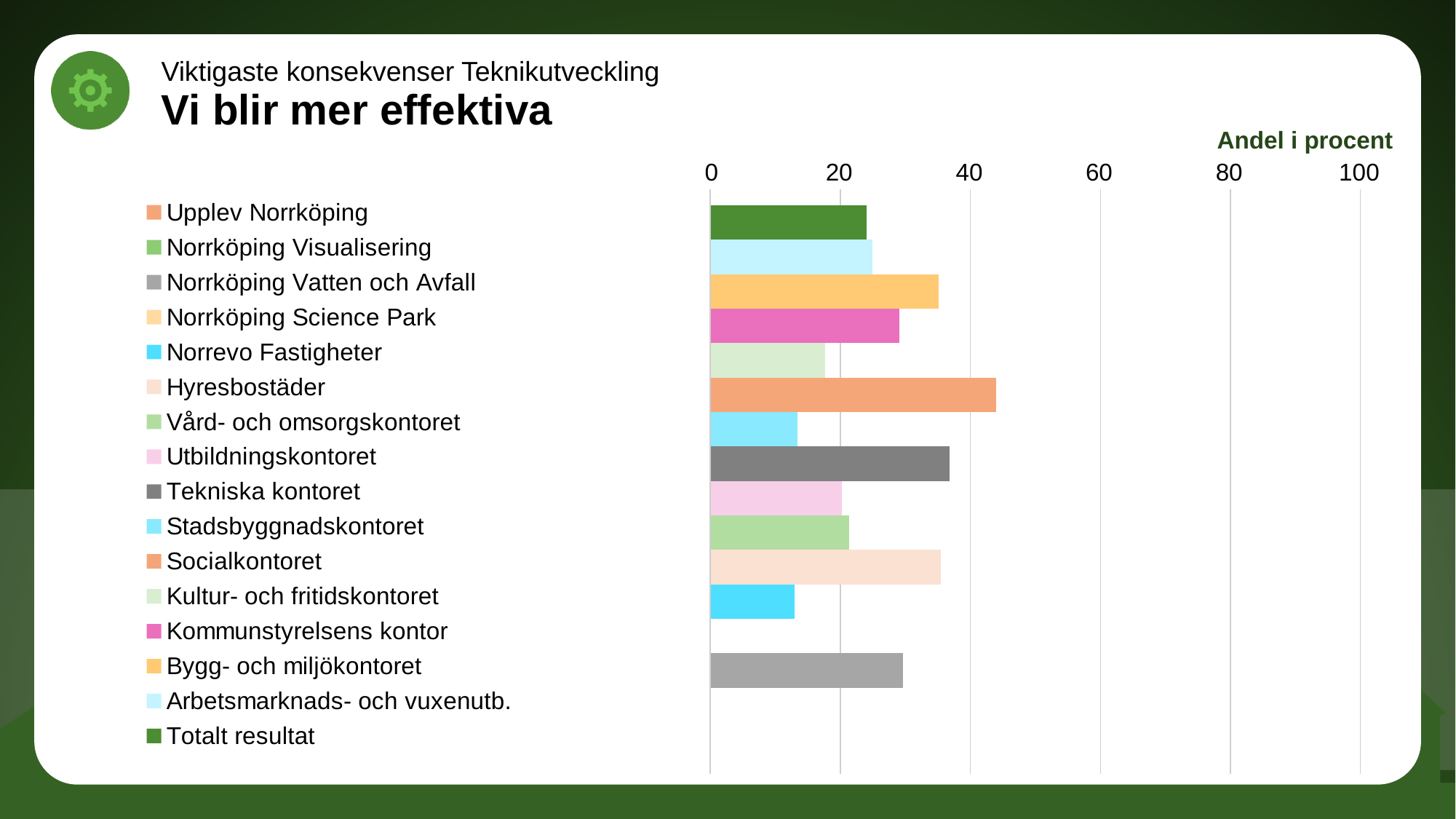
Is the value for Totalt resultat greater or less than 20? greater Is the value for Hyresbostäder greater or less than 20? greater What is the title of the chart's horizontal axis? Andel i procent Is the value for Tekniska kontoret greater or less than 40? less What kind of chart is shown on the slide? bar chart How many entries does the chart's legend list? 16 What is the highest value shown on the chart's horizontal axis? 100 How many bars are plotted in the chart? 13 Which is larger, the value for Hyresbostäder or the value for Totalt resultat? Hyresbostäder